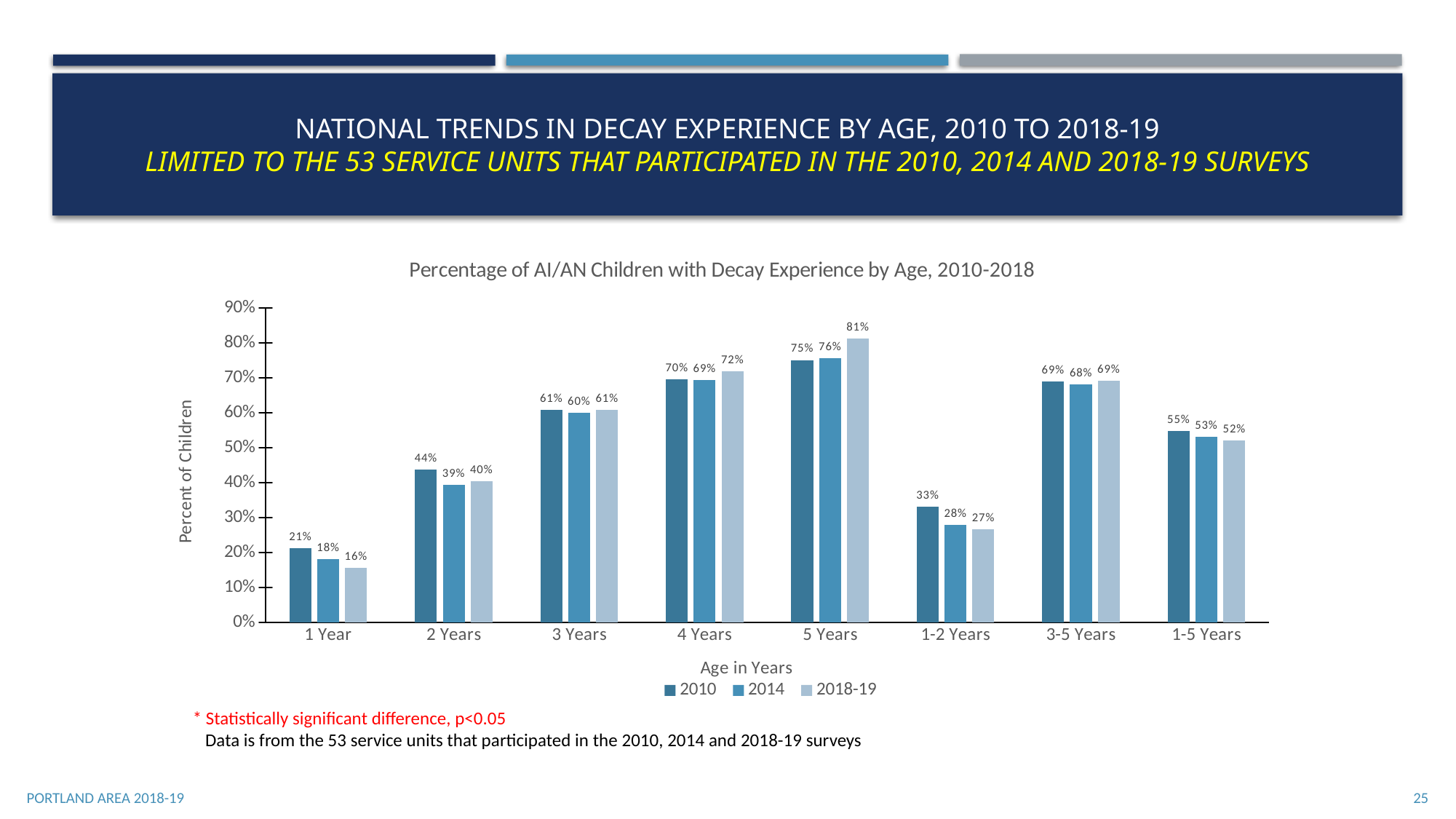
What is the difference between the 2010 and 2018-19 values in the 1-5 Years category? 3% How many age categories are shown on the x axis? 8 What is the difference between the 2010 and 2014 values in the 2 Years category? 5% What is the value for 2014 in the 1-2 Years category? 28% What is the label of the y axis? Percent of Children What kind of chart is shown on the slide? Bar chart Which age category has the lowest value for the 2010 series? 1 Year What is the value for 2010 in the 1 Year category? 21% Which age category has the highest value for the 2018-19 series? 5 Years What is the value for 2018-19 in the 5 Years category? 81% How many series does the legend list? 3 Which is larger, the 2010 value for 1-2 Years or the 2018-19 value for 1-2 Years? 2010